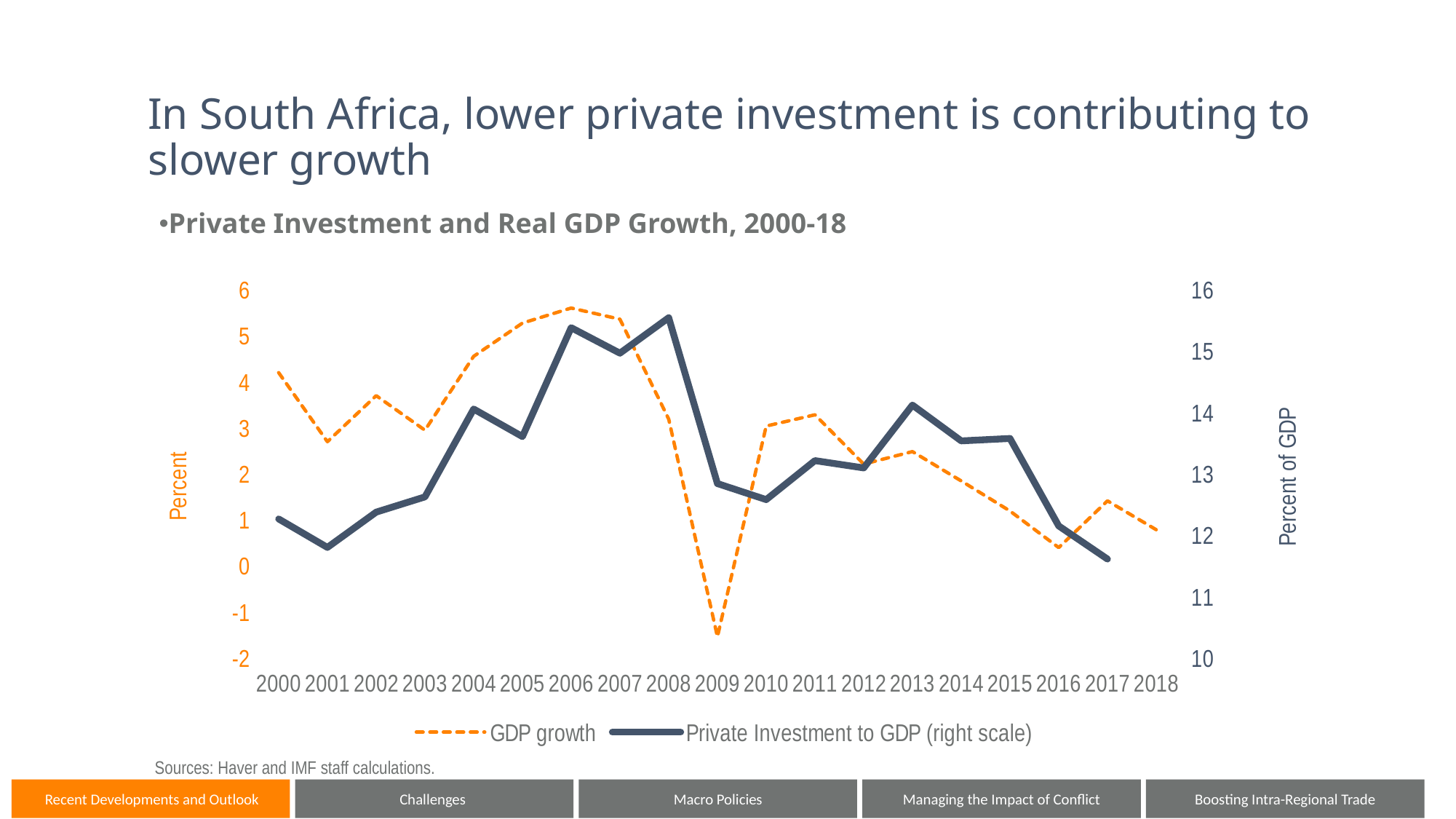
Which series is plotted on the right scale? Private Investment to GDP What is the label of the left vertical axis? Percent Which is larger, Private Investment to GDP in 2008 or in 2017? 2008 Is the value for GDP growth in 2009 greater or less than 0? less Does GDP growth rise or fall from 2013 to 2016? fall What kind of chart is shown on the slide? line chart Is the value for GDP growth in 2006 greater or less than 5? greater Is the value for Private Investment to GDP in 2017 greater or less than 12? less How many series does the legend list? 2 How many years are labelled on the x axis? 19 In which year is GDP growth lowest? 2009